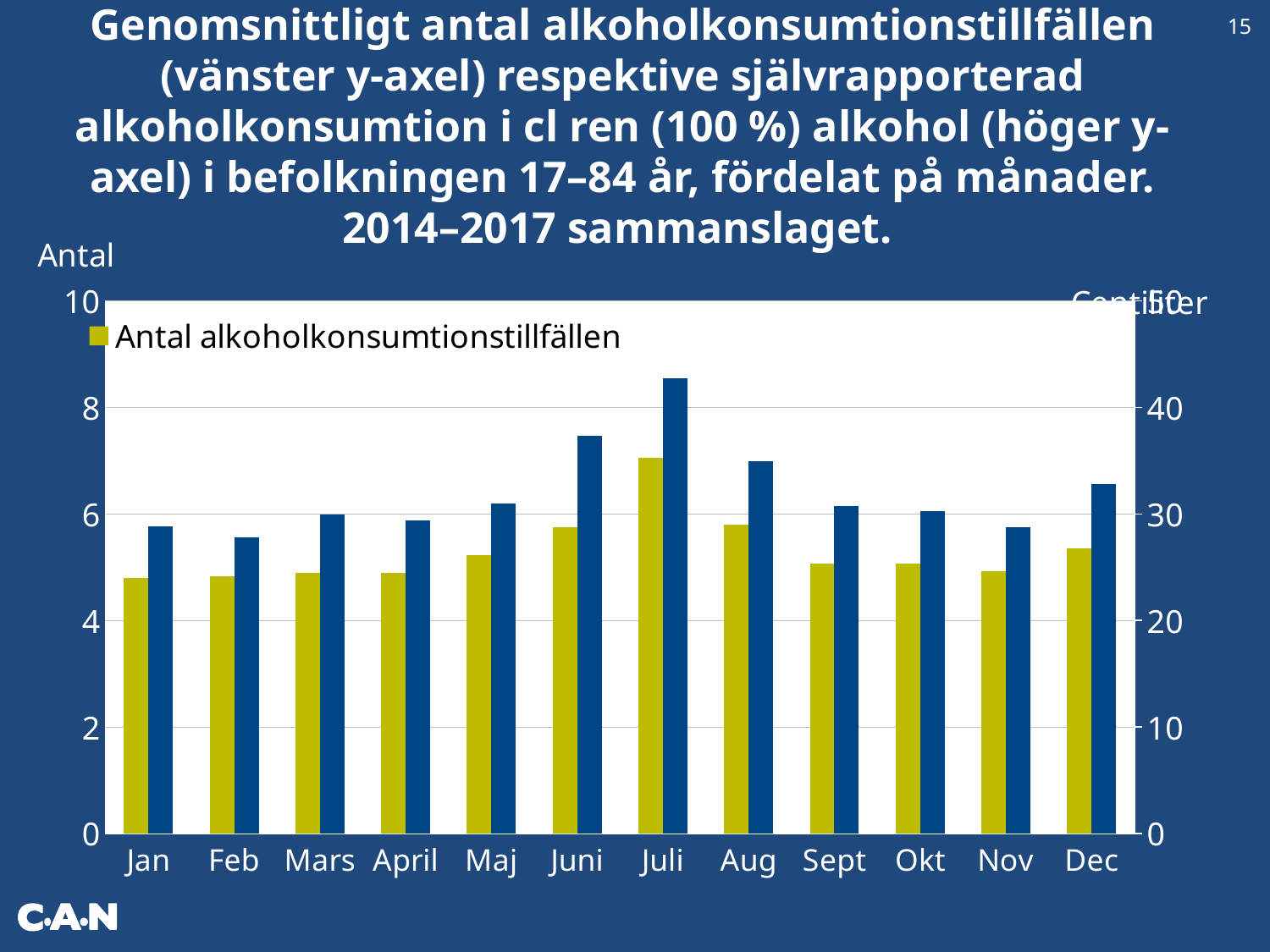
Which has the larger blue bar, Juni or Dec? Juni Is the yellow bar (Antal alkoholkonsumtionstillfällen) for Juli greater or less than 6? greater How many months (categories) are shown on the x axis? 12 What is the label of the left y axis? Antal Is the blue bar for Juli greater or less than 40 on the right axis? greater Is the blue bar for Juni greater or less than 30 on the right axis? greater Which month has the highest blue bar (right axis, centiliter)? Juli Which month has the highest yellow bar (Antal alkoholkonsumtionstillfällen)? Juli What kind of chart is shown on the slide? Bar chart Which has the larger yellow bar (Antal alkoholkonsumtionstillfällen), Juli or Jan? Juli What series name is shown in the legend? Antal alkoholkonsumtionstillfällen